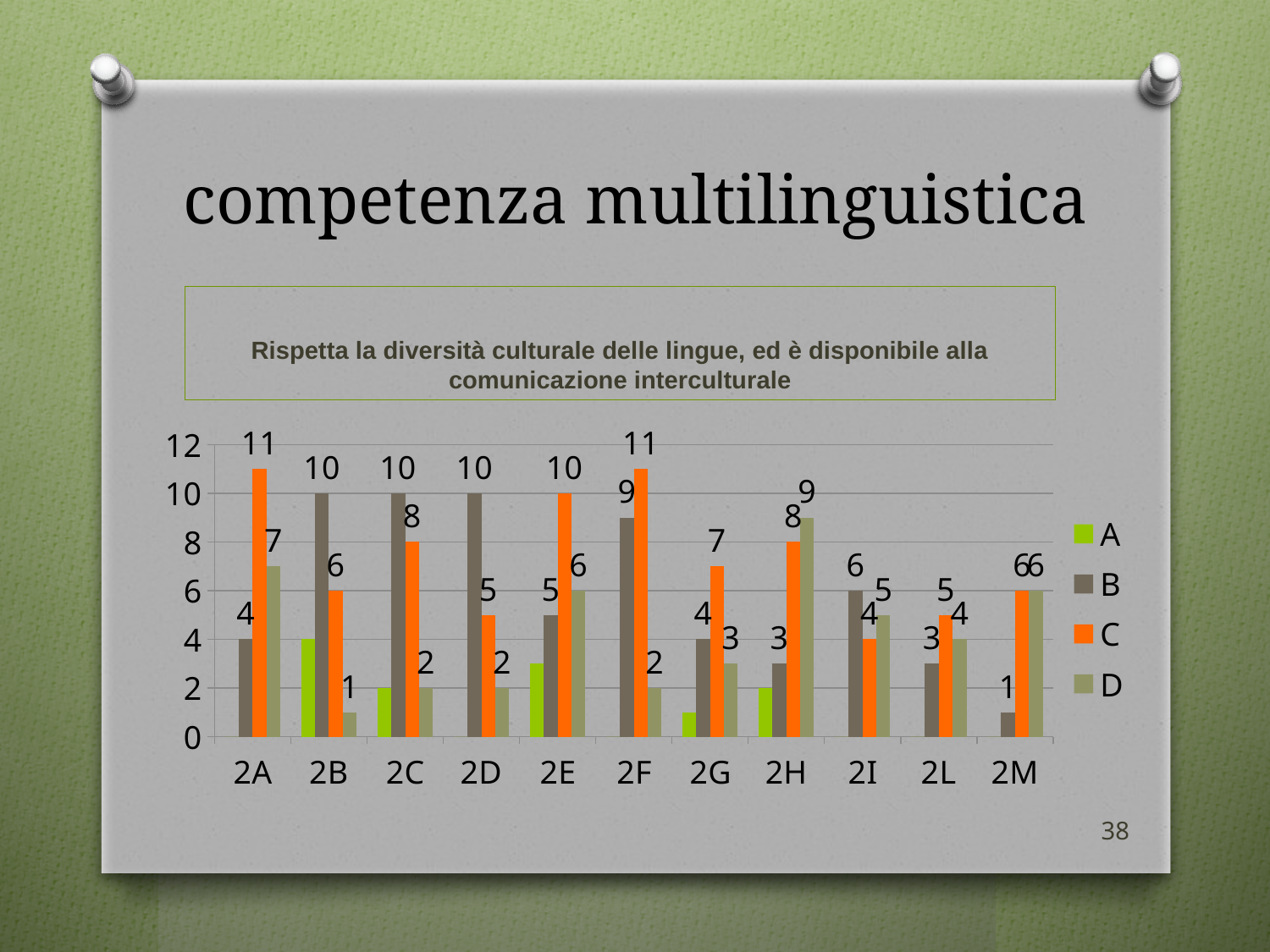
What is the value of series B for category 2B? 10 What kind of chart is shown on the slide? bar chart What is the difference between the values of series C and series B for category 2A? 7 What are the entries in the chart legend? A, B, C, D Is the value of series A for category 2B greater or less than 2? greater How many categories are shown on the x axis? 11 What is the value of series C for category 2A? 11 What is the value of series D for category 2H? 9 Which category has the highest value for series D? 2H How many series does the legend list? 4 For category 2E, which series has the larger value, B or C? C Which category has the lowest value for series B? 2M